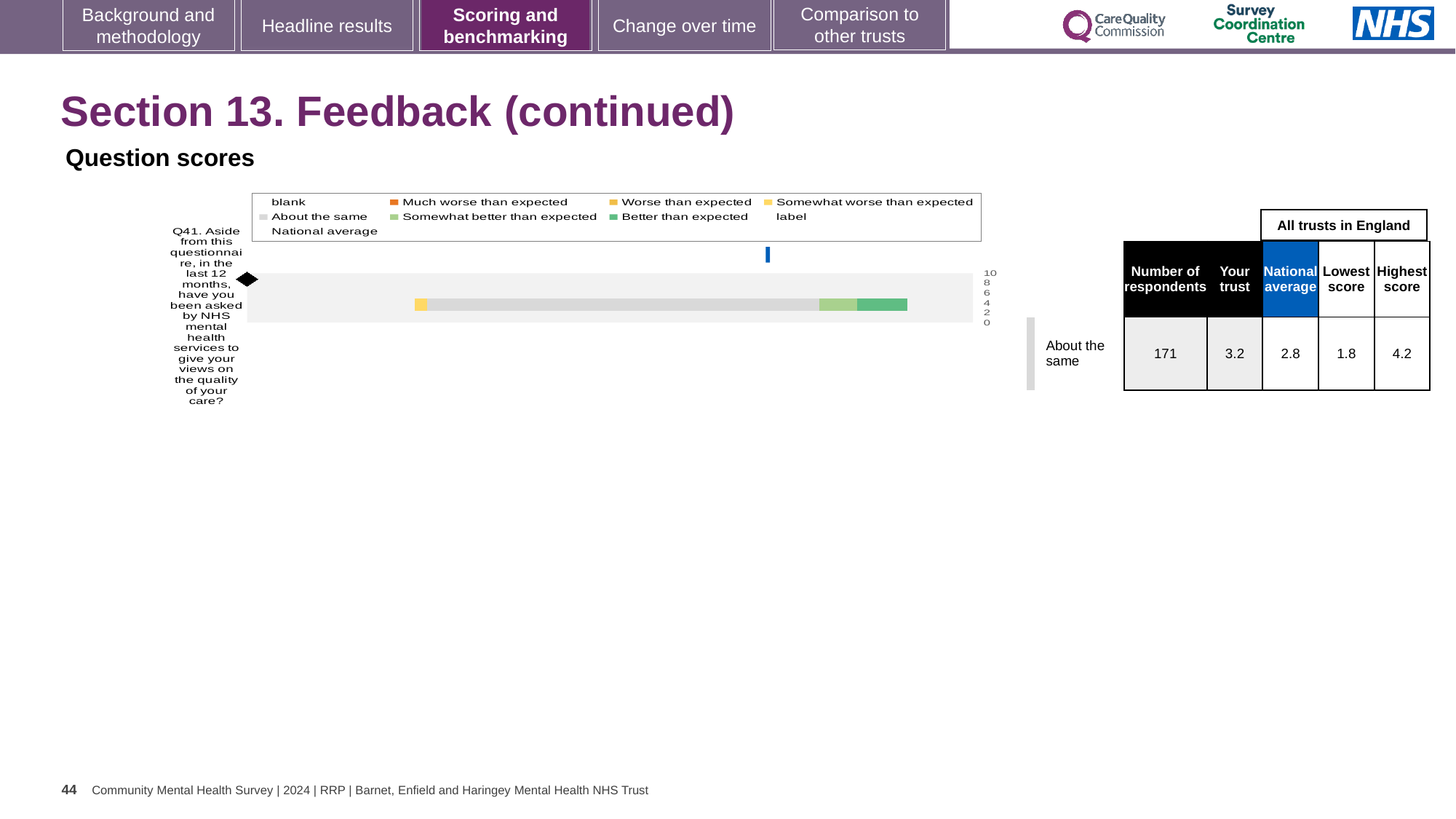
What kind of chart is shown on the slide? bar chart What is the difference between the 'Your trust' score and the national average for Q41? 0.4 What is the difference between the highest and lowest scores for Q41? 2.4 What is the 'Your trust' score for Q41? 3.2 What is the number of respondents for Q41? 171 Which question is plotted in the chart? Q41. Aside from this questionnaire, in the last 12 months, have you been asked by NHS mental health services to give your views on the quality of your care? What benchmark category is shown for Q41? About the same What is the national average score for Q41? 2.8 Which is larger for Q41, the 'Your trust' score or the national average? Your trust What is the highest score among all trusts in England for Q41? 4.2 What is the lowest score among all trusts in England for Q41? 1.8 How many questions are plotted in the chart? 1